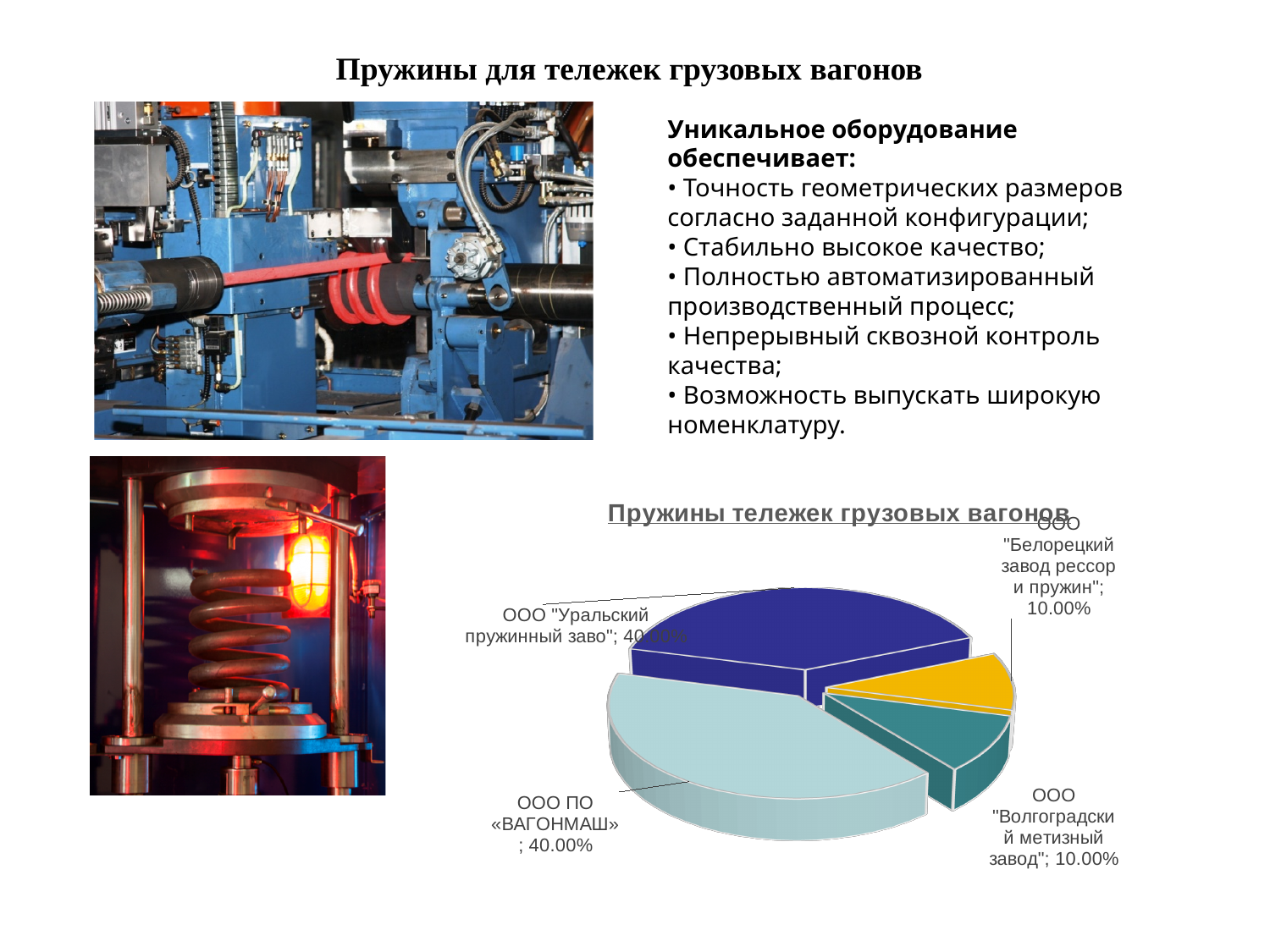
What share of the pie does ООО ПО «ВАГОНМАШ» hold? 40.00% What share of the pie does ООО "Волгоградский метизный завод" hold? 10.00% Which has the larger share: ООО ПО «ВАГОНМАШ» or ООО "Белорецкий завод рессор и пружин"? ООО ПО «ВАГОНМАШ» What is the difference between the shares of ООО ПО «ВАГОНМАШ» and ООО "Волгоградский метизный завод"? 30.00% What share of the pie does ООО "Уральский пружинный заво" hold? 40.00% What kind of chart is shown on the slide? pie chart Which slice of the pie chart is coloured yellow? ООО "Белорецкий завод рессор и пружин" What is the title of the chart on the slide? Пружины тележек грузовых вагонов What share of the pie does ООО "Белорецкий завод рессор и пружин" hold? 10.00% How many slices does the pie chart have? 4 What is the combined share of ООО "Белорецкий завод рессор и пружин" and ООО "Волгоградский метизный завод"? 20.00% Is the share for ООО "Волгоградский метизный завод" greater or less than 20%? less